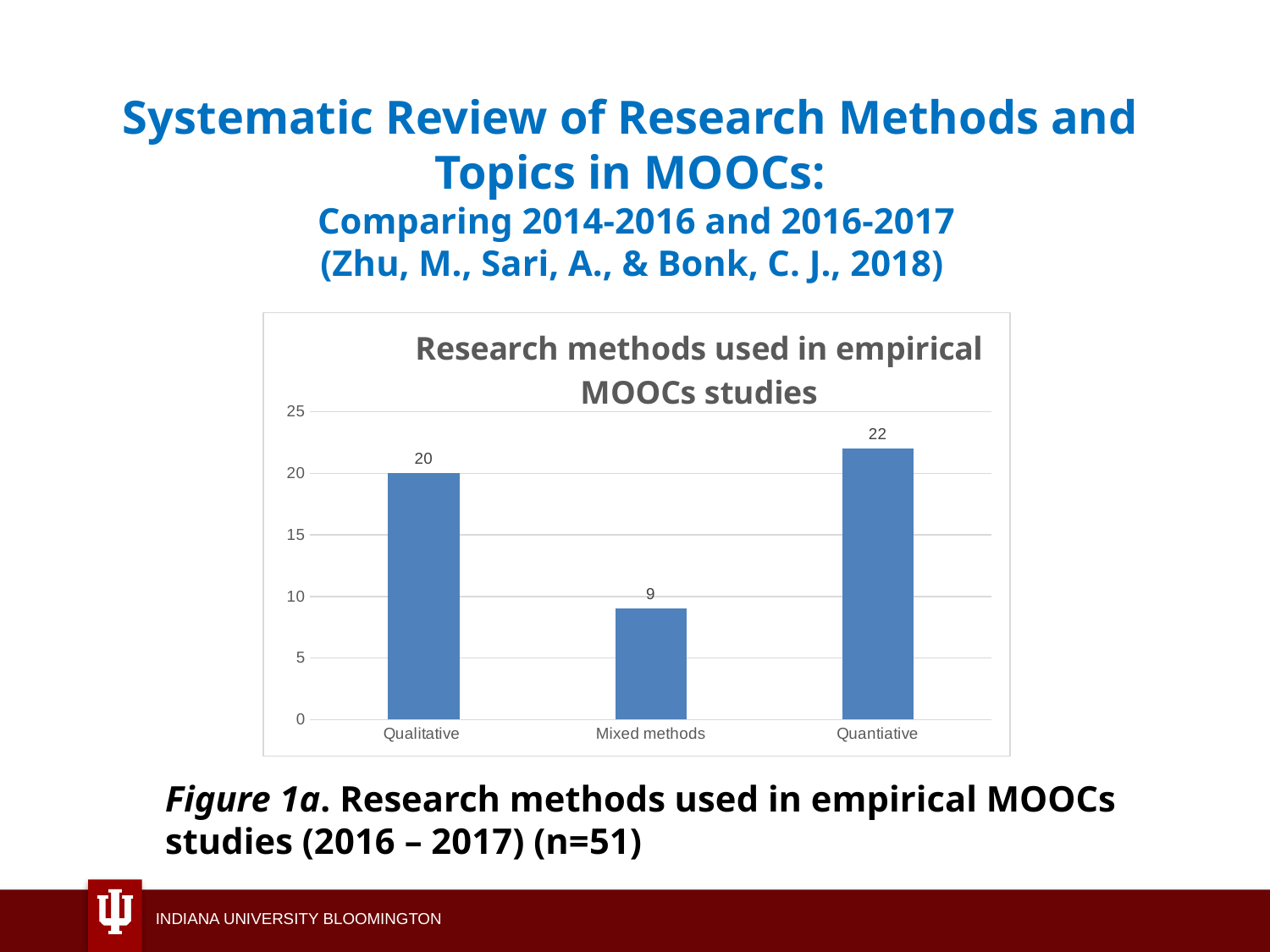
Is the value for Mixed methods greater or less than 10? less What is the difference between the values for Qualitative and Mixed methods? 11 What is the value for Mixed methods? 9 What kind of chart is shown on the slide? bar chart What is the value for Qualitative? 20 What is the title of the chart? Research methods used in empirical MOOCs studies Which category has the highest value? Quantiative Which category has the lowest value? Mixed methods What is the difference between the values for Quantiative and Qualitative? 2 How many categories are shown in the chart? 3 What is the value for Quantiative? 22 Which is larger, the value for Qualitative or the value for Mixed methods? Qualitative